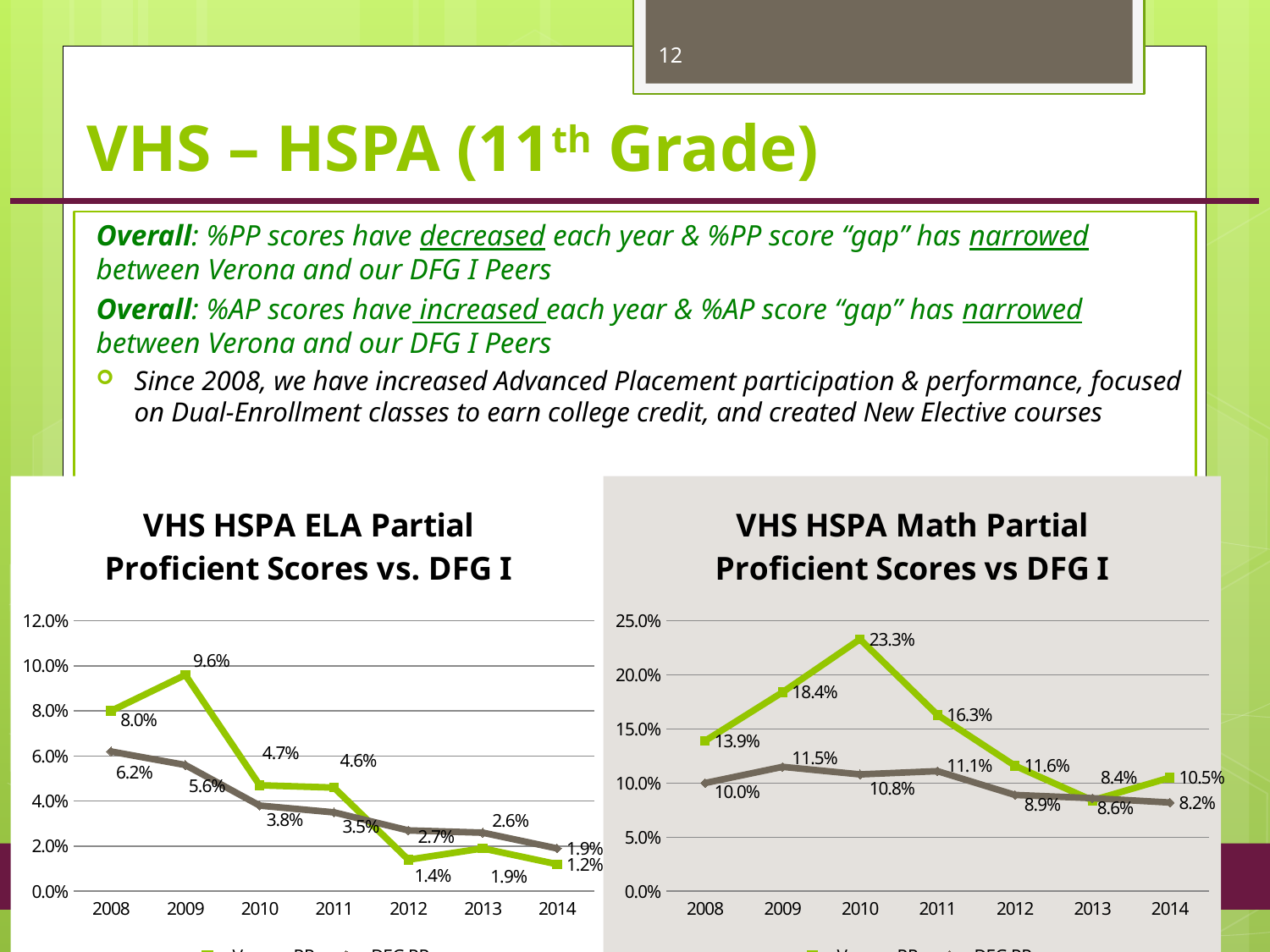
In the VHS HSPA ELA Partial Proficient Scores vs. DFG I chart, in which year is the green line at its lowest value? 2014 In the VHS HSPA Math Partial Proficient Scores vs DFG I chart, which line has the higher value in 2013, the green line or the grey line? grey line In the VHS HSPA ELA Partial Proficient Scores vs. DFG I chart, what is the value of the grey line in 2014? 1.9% What kind of chart is the VHS HSPA ELA Partial Proficient Scores vs. DFG I chart? line chart In the VHS HSPA Math Partial Proficient Scores vs DFG I chart, what is the difference between the green line and the grey line in 2010? 12.5% In the VHS HSPA Math Partial Proficient Scores vs DFG I chart, is the green line's 2009 value greater or less than 15.0%? greater How many years are shown on the x axis of the VHS HSPA Math Partial Proficient Scores vs DFG I chart? 7 In the VHS HSPA ELA Partial Proficient Scores vs. DFG I chart, does the grey line generally rise or fall from 2008 to 2014? fall In the VHS HSPA ELA Partial Proficient Scores vs. DFG I chart, what is the value of the green line in 2009? 9.6% In the VHS HSPA ELA Partial Proficient Scores vs. DFG I chart, what is the difference between the green line's 2008 and 2014 values? 6.8% In the VHS HSPA Math Partial Proficient Scores vs DFG I chart, in which year does the green line reach its highest value? 2010 In the VHS HSPA Math Partial Proficient Scores vs DFG I chart, what is the value of the green line in 2010? 23.3%